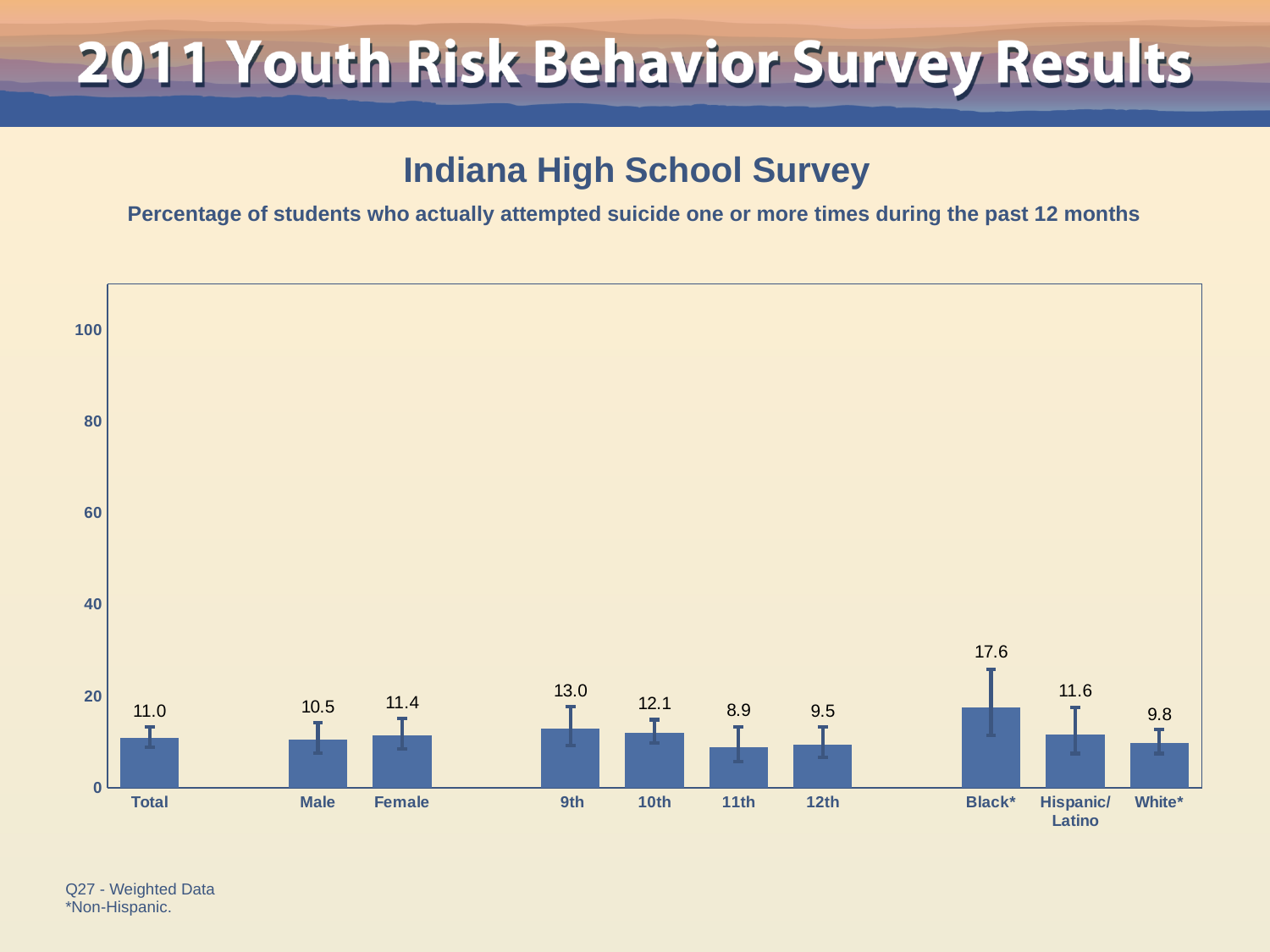
Which category has the lowest value? 11th Which category has the highest value? Black* Which is larger, the value for Male or the value for Female? Female What is the difference between the values for Black* and White*? 7.8 How many categories are shown on the x axis? 10 What is the value for Hispanic/Latino? 11.6 What is the value for Female? 11.4 Is the value for Black* greater or less than 20? less What is the value for Total? 11.0 Do the values rise or fall from 9th to 11th grade? fall What kind of chart is shown on the slide? bar chart What is the value for 11th? 8.9